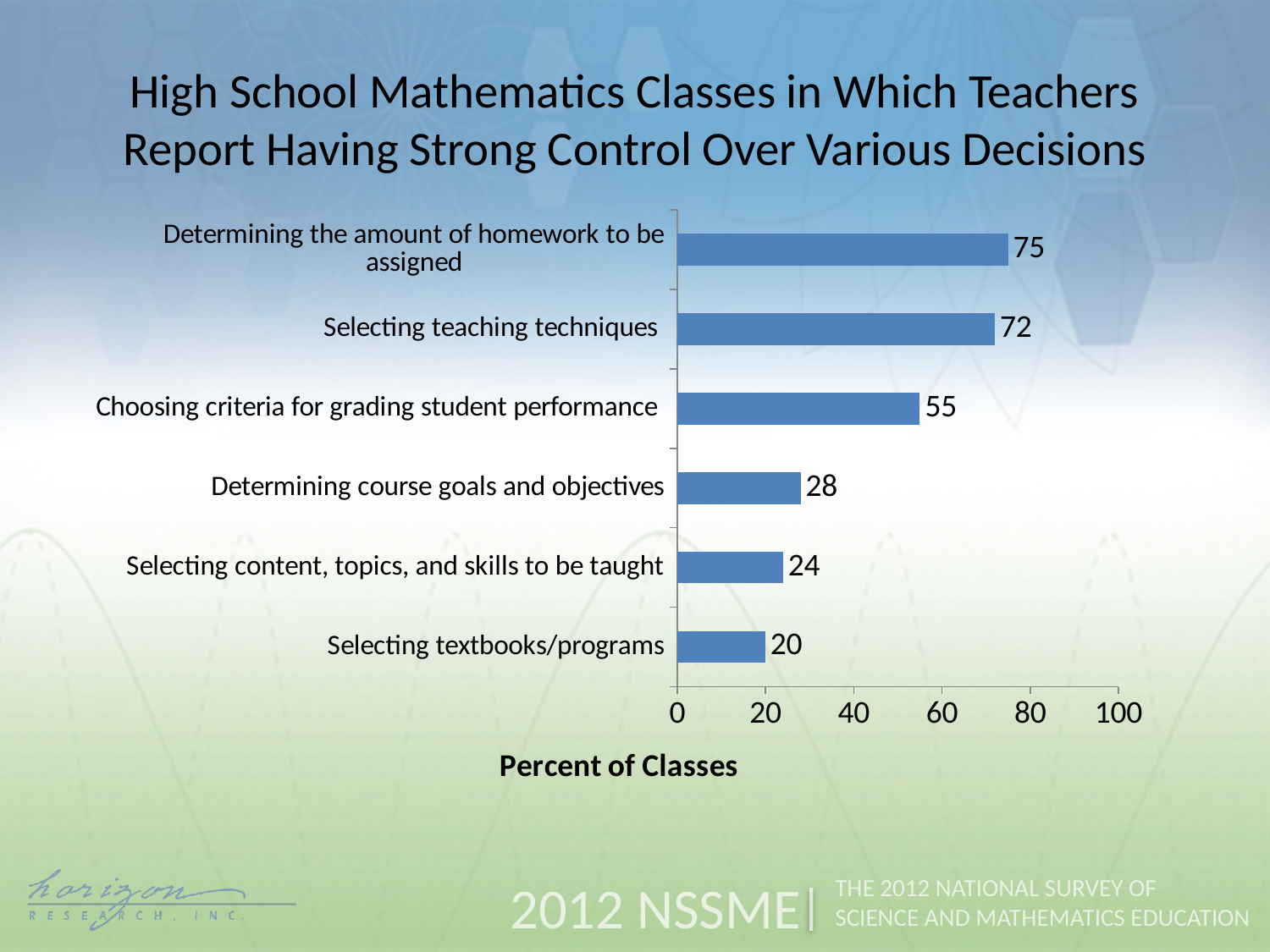
Which decision has the highest percent of classes? Determining the amount of homework to be assigned Is the value for Choosing criteria for grading student performance greater or less than 60? less Which decision has the lowest percent of classes? Selecting textbooks/programs What kind of chart is shown on the slide? bar chart What is the value for Choosing criteria for grading student performance? 55 How many decision categories are shown in the chart? 6 What percent of classes is shown for Determining the amount of homework to be assigned? 75 What is the label of the horizontal axis? Percent of Classes Which is larger: the value for Selecting content, topics, and skills to be taught or the value for Determining course goals and objectives? Determining course goals and objectives What is the difference between the highest and lowest values in the chart? 55 What is the difference between the values for Selecting teaching techniques and Determining course goals and objectives? 44 What is the value for Selecting textbooks/programs? 20